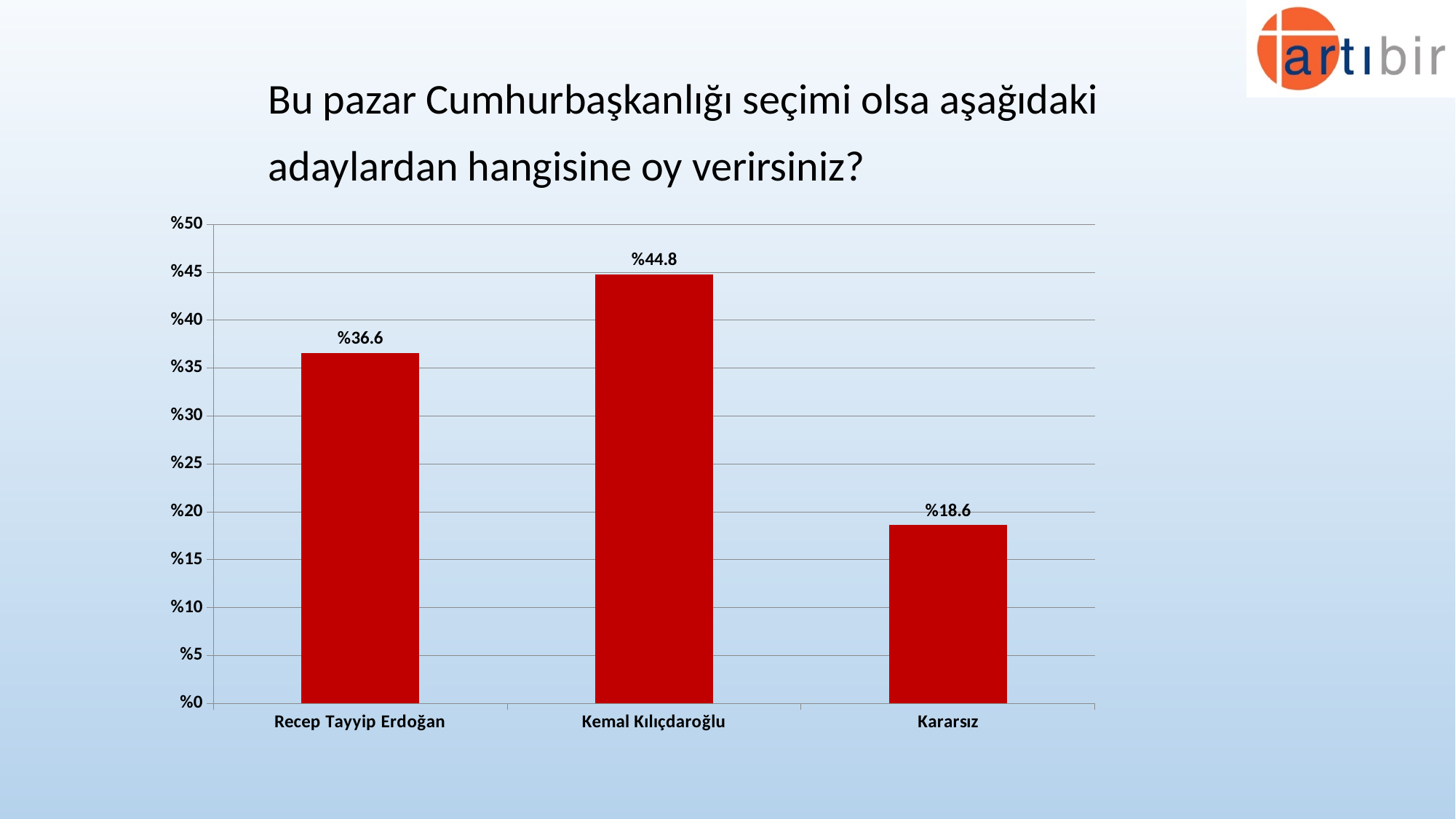
What kind of chart is shown on the slide? Bar chart What is the value for Recep Tayyip Erdoğan? %36.6 Which category has the highest value? Kemal Kılıçdaroğlu Which category has the lowest value? Kararsız What is the difference between the values for Kemal Kılıçdaroğlu and Recep Tayyip Erdoğan? %8.2 What is the value for Kararsız? %18.6 How many categories are shown on the x axis? 3 What is the value for Kemal Kılıçdaroğlu? %44.8 What is the difference between the values for Recep Tayyip Erdoğan and Kararsız? %18.0 What colour are the bars in the chart? Red Is the value for Kemal Kılıçdaroğlu greater or less than %40? greater Which is larger, the value for Recep Tayyip Erdoğan or the value for Kararsız? Recep Tayyip Erdoğan